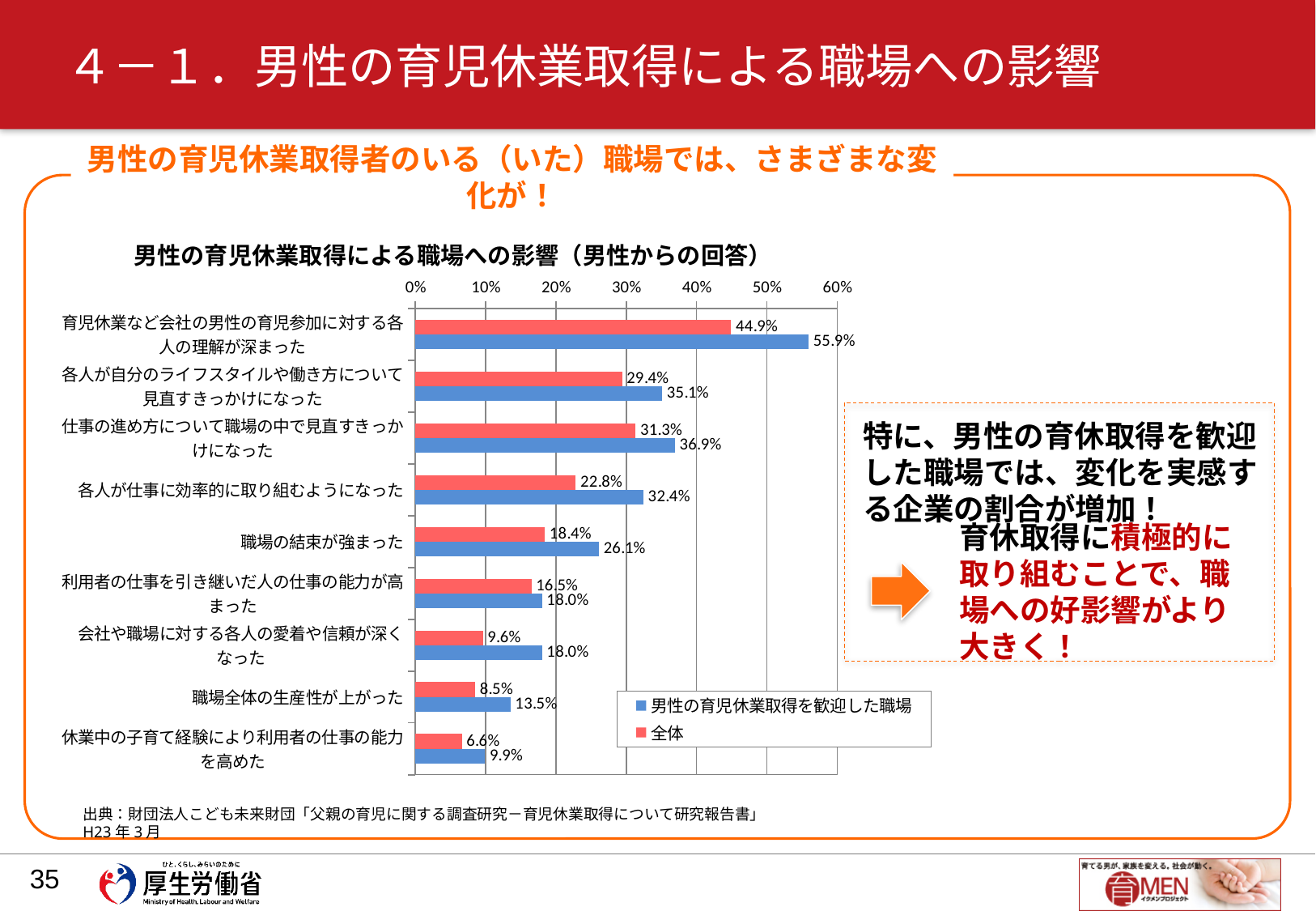
Which category has the highest value for 男性の育児休業取得を歓迎した職場? 育児休業など会社の男性の育児参加に対する各人の理解が深まった How many categories are plotted in the chart? 9 Which colour represents the 全体 series in the chart? red For 仕事の進め方について職場の中で見直すきっかけになった, which series has the larger value, 男性の育児休業取得を歓迎した職場 or 全体? 男性の育児休業取得を歓迎した職場 Which category has the lowest value for 全体? 休業中の子育て経験により利用者の仕事の能力を高めた What is the value of 全体 for 職場全体の生産性が上がった? 8.5% How many series does the legend list? 2 What is the difference between the 男性の育児休業取得を歓迎した職場 value and the 全体 value for 会社や職場に対する各人の愛着や信頼が深くなった? 8.4% What is the value of 全体 for 職場の結束が強まった? 18.4% What type of chart is shown on the slide? bar chart What is the value of 男性の育児休業取得を歓迎した職場 for 各人が仕事に効率的に取り組むようになった? 32.4% What is the difference between the two series for 育児休業など会社の男性の育児参加に対する各人の理解が深まった? 11.0%